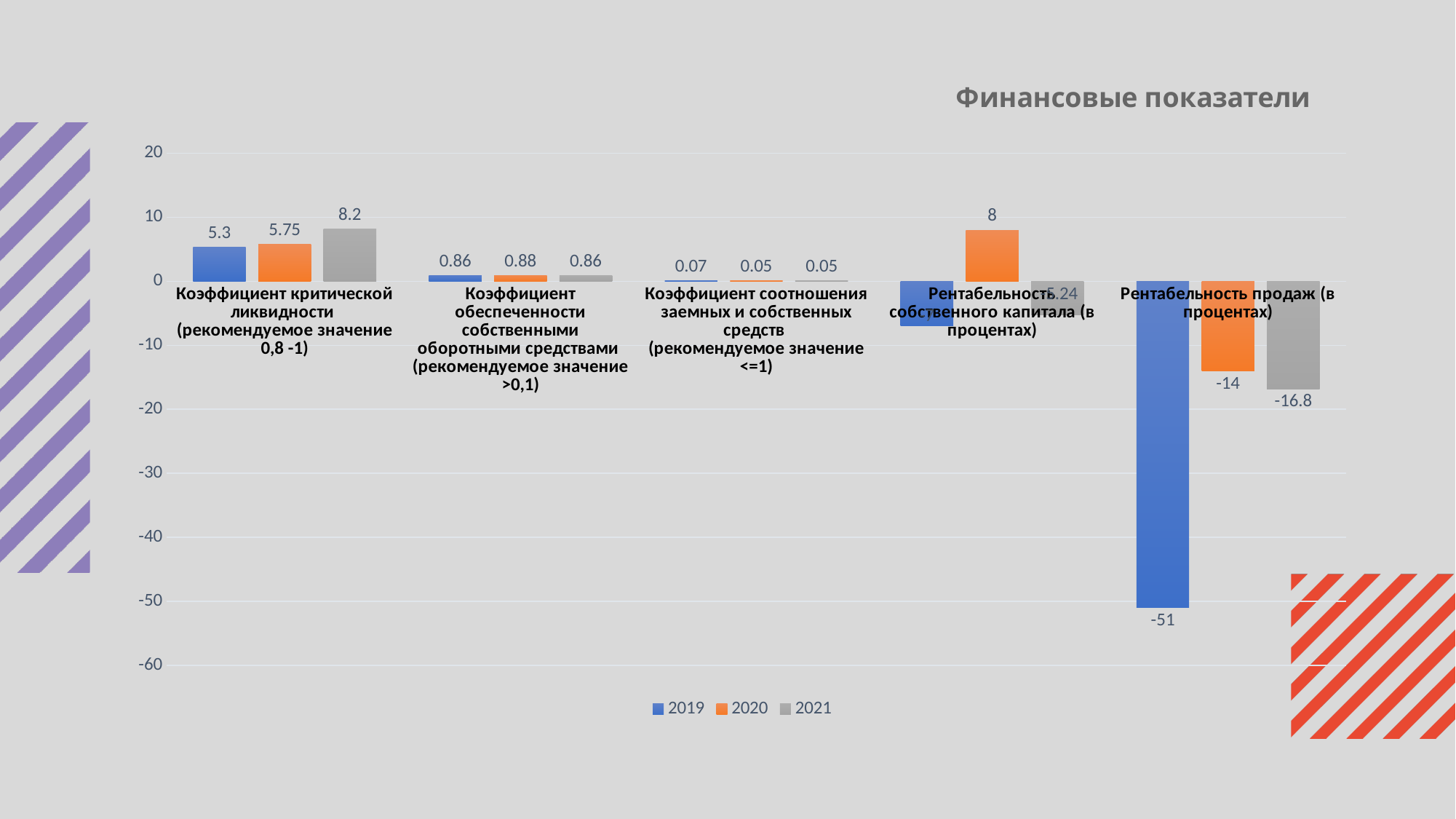
Which is larger for Рентабельность продаж (в процентах): the 2020 value or the 2021 value? 2020 What is the 2019 value for Рентабельность продаж (в процентах)? -51 What is the 2021 value for Коэффициент критической ликвидности? 8.2 What is the 2020 value for Коэффициент обеспеченности собственными оборотными средствами? 0.88 How many series does the legend list? 3 What kind of chart is shown on the slide? bar chart What is the difference between the 2021 and 2019 values for Коэффициент критической ликвидности? 2.9 What is the 2020 value for Рентабельность собственного капитала (в процентах)? 8 What is the title of the chart? Финансовые показатели How many categories are shown on the x axis? 5 Which year has the highest value for Коэффициент критической ликвидности? 2021 Which year has the lowest value for Рентабельность продаж (в процентах)? 2019